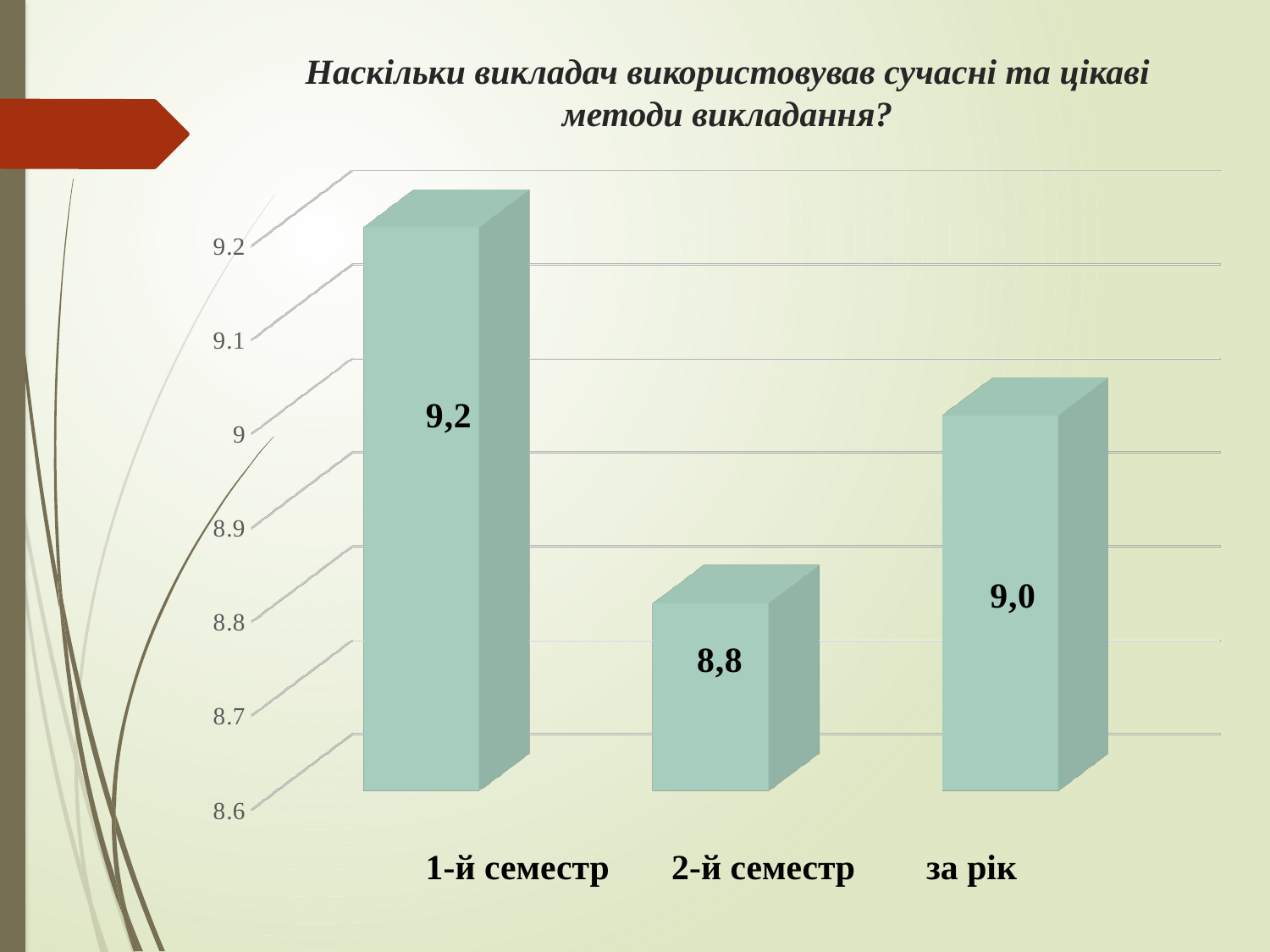
What is the value for 1-й семестр? 9,2 Which category has the highest value? 1-й семестр Which category has the lowest value? 2-й семестр What is the difference between the values for 1-й семестр and 2-й семестр? 0,4 Which is larger, the value for 1-й семестр or the value for за рік? 1-й семестр What is the title of the chart? Наскільки викладач використовував сучасні та цікаві методи викладання? What kind of chart is shown on the slide? bar chart What is the value for за рік? 9,0 What is the value for 2-й семестр? 8,8 What is the difference between the values for за рік and 2-й семестр? 0,2 How many categories are shown on the x axis? 3 Is the value for 2-й семестр greater or less than 9? less